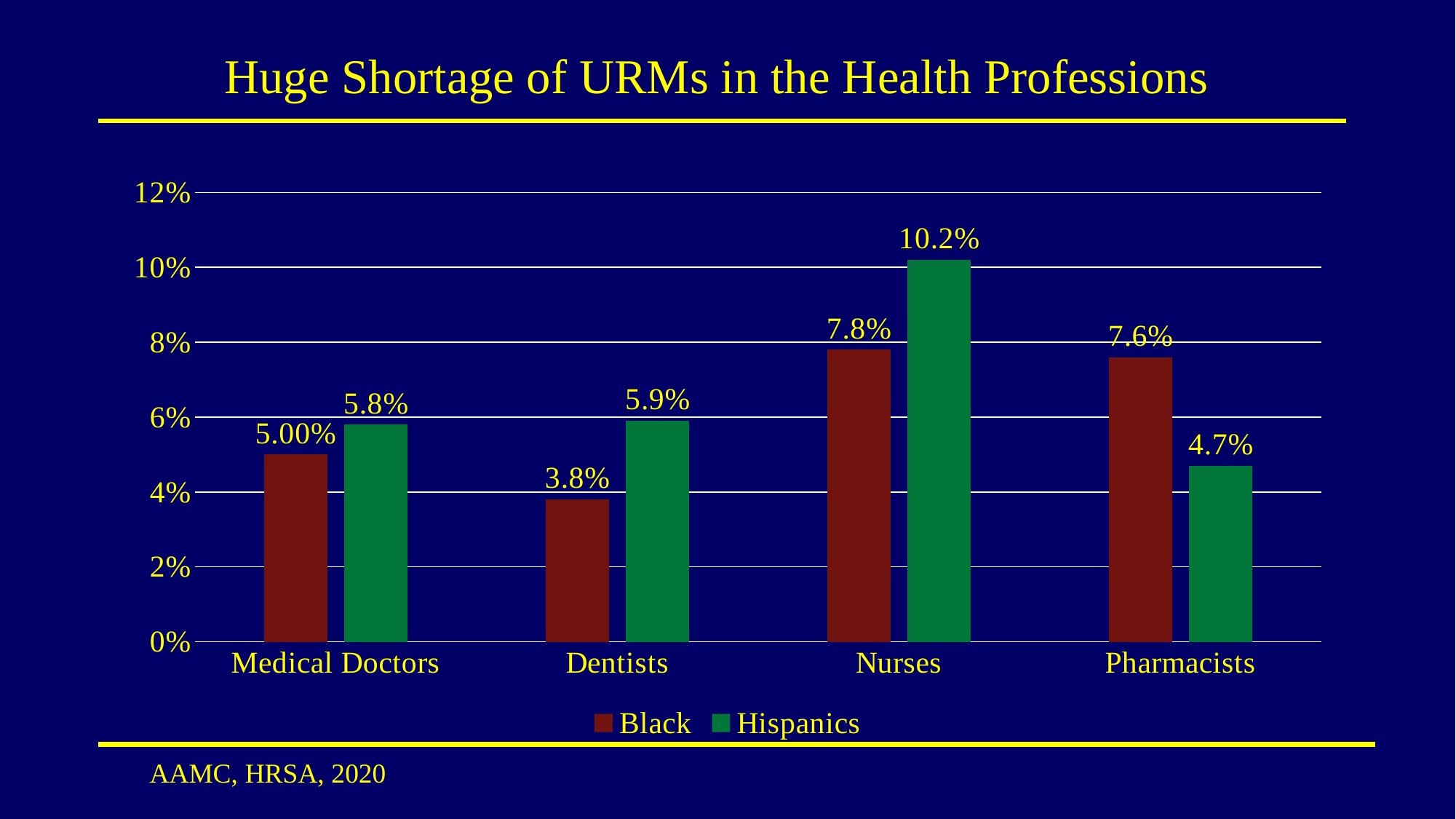
What is the value for Black among Medical Doctors? 5.00% What is the difference between the Hispanics and Black values for Nurses? 2.4% What kind of chart is shown on the slide? Bar chart Which profession has the lowest value for Black? Dentists What is the value for Hispanics among Dentists? 5.9% Which is larger for Pharmacists, the Black value or the Hispanics value? Black What is the value for Black among Nurses? 7.8% Which profession has the highest value for Hispanics? Nurses How many series does the legend list? 2 Is the value for Hispanics among Nurses greater or less than 10%? greater What is the title of the chart? Huge Shortage of URMs in the Health Professions How many professions are shown on the x axis? 4